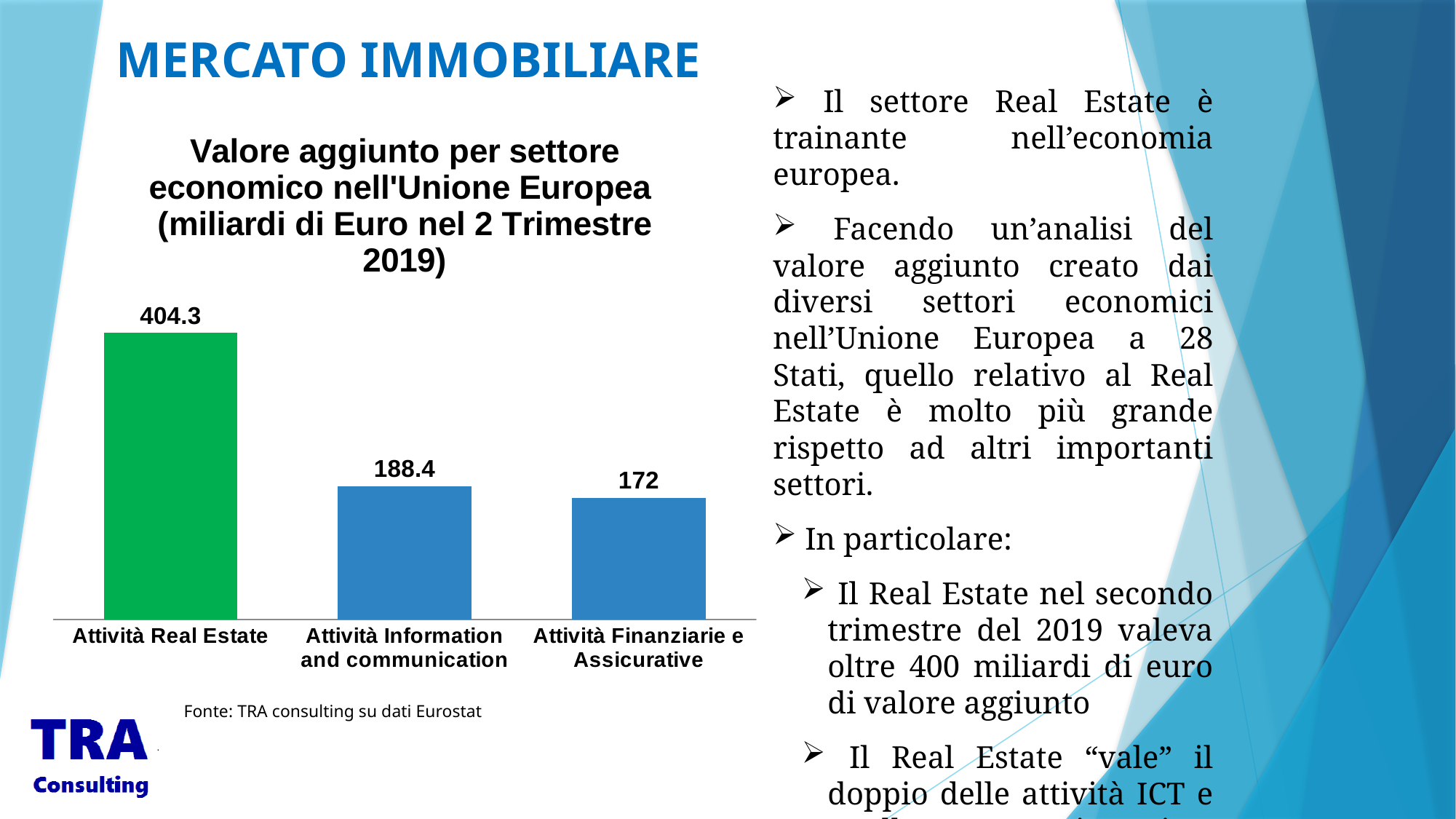
What is the value for Attività Information and communication? 188.4 Which category has the highest value? Attività Real Estate Which is larger, the value for Attività Information and communication or the value for Attività Finanziarie e Assicurative? Attività Information and communication Which category has the lowest value? Attività Finanziarie e Assicurative What is the difference between the values for Attività Real Estate and Attività Information and communication? 215.9 What kind of chart is shown on the slide? bar chart What is the title of the chart? Valore aggiunto per settore economico nell'Unione Europea (miliardi di Euro nel 2 Trimestre 2019) Do the values rise or fall from left to right across the categories? fall What is the value for Attività Finanziarie e Assicurative? 172 What is the difference between the values for Attività Information and communication and Attività Finanziarie e Assicurative? 16.4 How many categories are shown in the chart? 3 What is the value for Attività Real Estate? 404.3